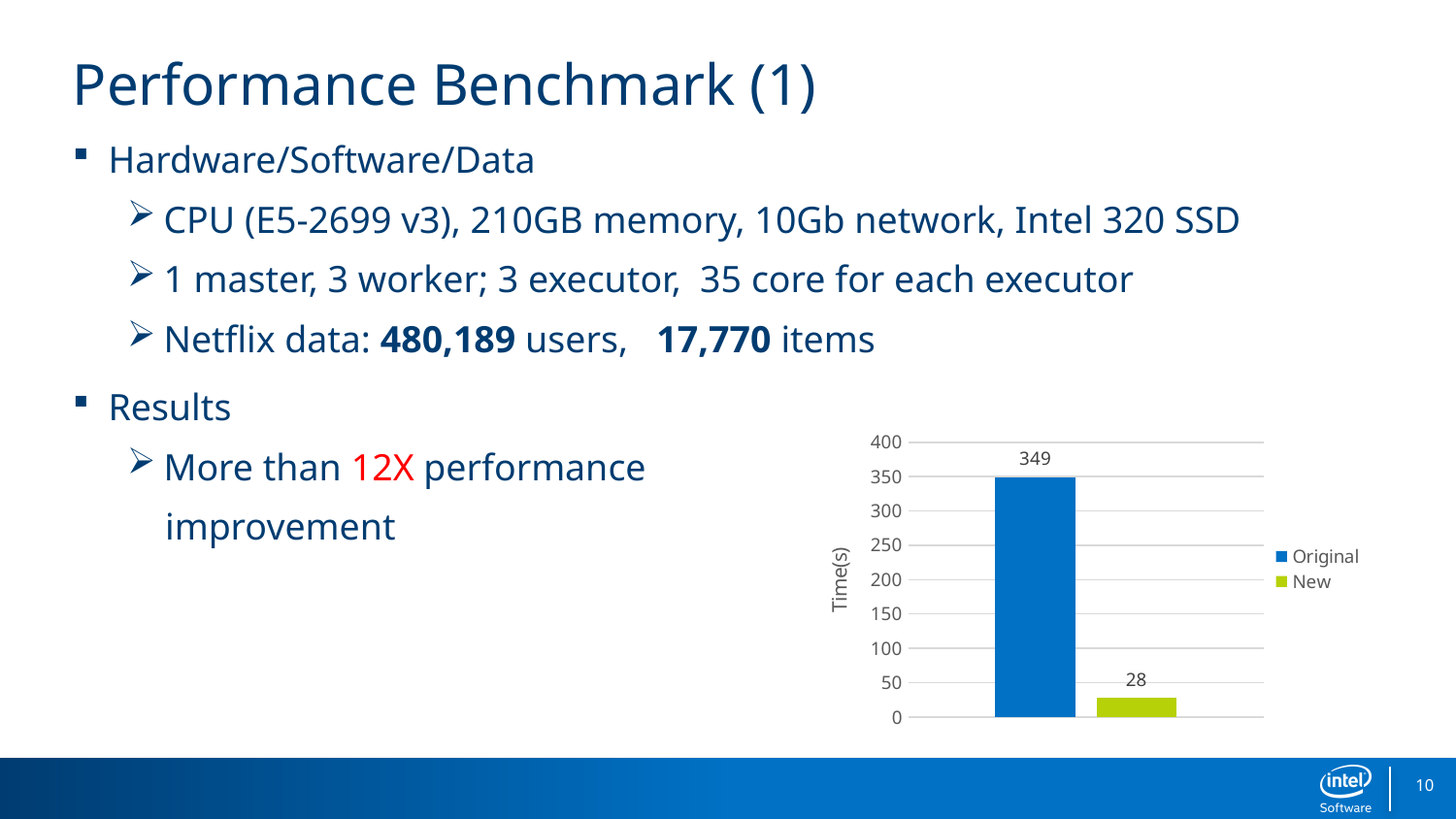
Which series has the higher value, Original or New? Original What is the value for the Original series in the chart? 349 How many series does the legend list? 2 How many bars are plotted in the chart? 2 Is the value for Original greater or less than 300? greater What is the maximum value shown on the vertical axis of the chart? 400 What kind of chart is shown on the slide? bar chart Is the value for New greater or less than 50? less What is the value for the New series in the chart? 28 What is the difference between the Original and New values? 321 Which series has the lowest value in the chart? New What is the label of the vertical axis of the chart? Time(s)